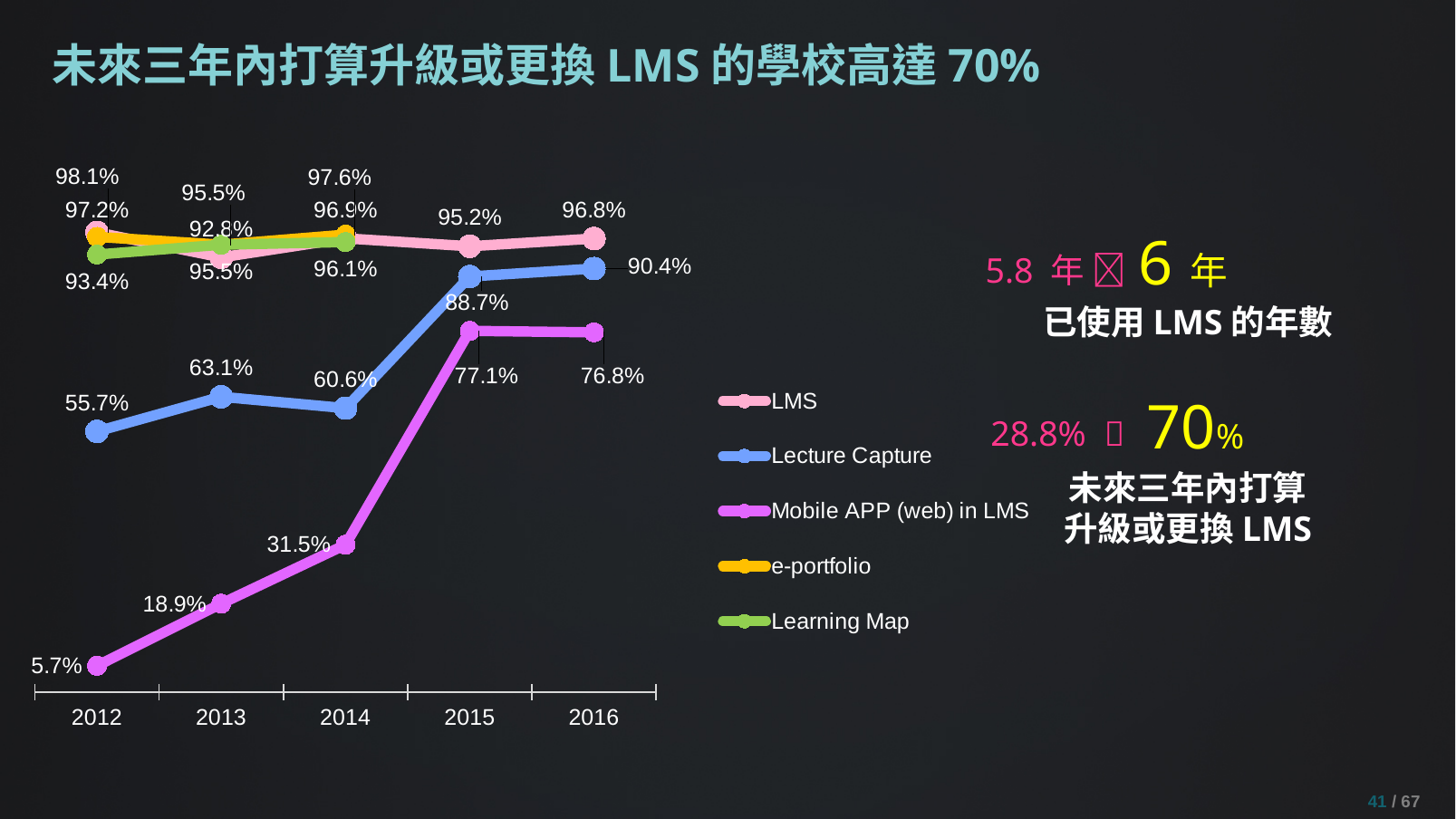
What is the value for Lecture Capture in 2016? 90.4% What is the value for Lecture Capture in 2013? 63.1% What is the difference between the Lecture Capture values in 2016 and 2012? 34.7 percentage points What is the value for LMS in 2016? 96.8% What is the value for Mobile APP (web) in LMS in 2015? 77.1% How many series does the legend list? 5 In 2015, which is larger: Lecture Capture or Mobile APP (web) in LMS? Lecture Capture What is the value for Mobile APP (web) in LMS in 2012? 5.7% In which year is the Lecture Capture value highest? 2016 In which year is the Mobile APP (web) in LMS value lowest? 2012 What kind of chart is shown on the slide? Line chart Does the Mobile APP (web) in LMS value rise or fall from 2012 to 2015? Rise